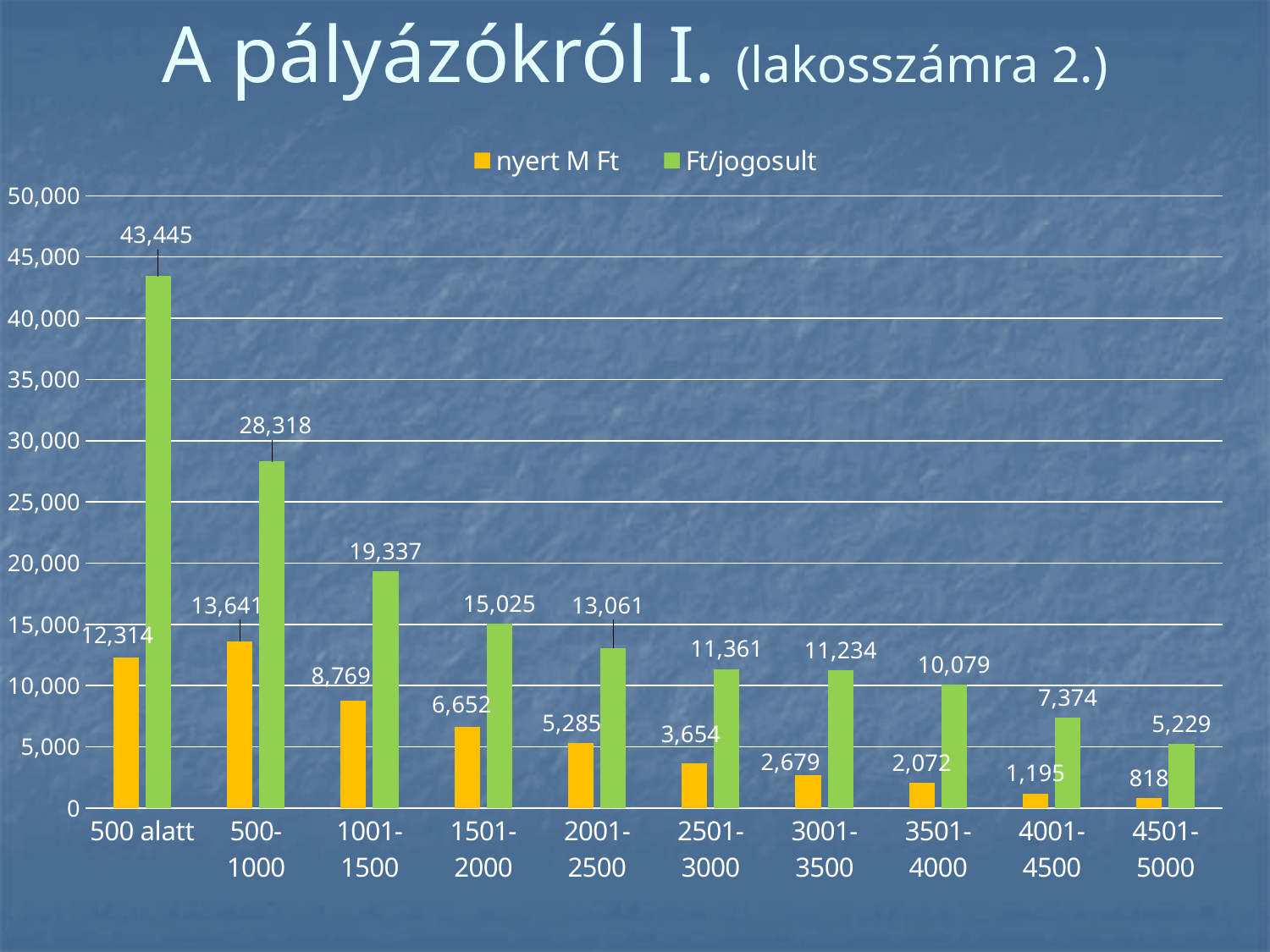
What is the difference between the Ft/jogosult values for 500 alatt and 500-1000? 15,127 Which is larger: the nyert M Ft value for 2001-2500 or for 2501-3000? 2001-2500 What is the nyert M Ft value for the 1001-1500 category? 8,769 How many series does the legend list? 2 How many categories are shown on the x axis? 10 What is the Ft/jogosult value for the 4001-4500 category? 7,374 Is the Ft/jogosult value for 1001-1500 greater or less than 20,000? less Which category has the lowest Ft/jogosult value? 4501-5000 Do the Ft/jogosult values rise or fall from left to right along the x axis? fall What is the Ft/jogosult value for the 500 alatt category? 43,445 What kind of chart is shown on the slide? bar chart Which category has the highest nyert M Ft value? 500-1000